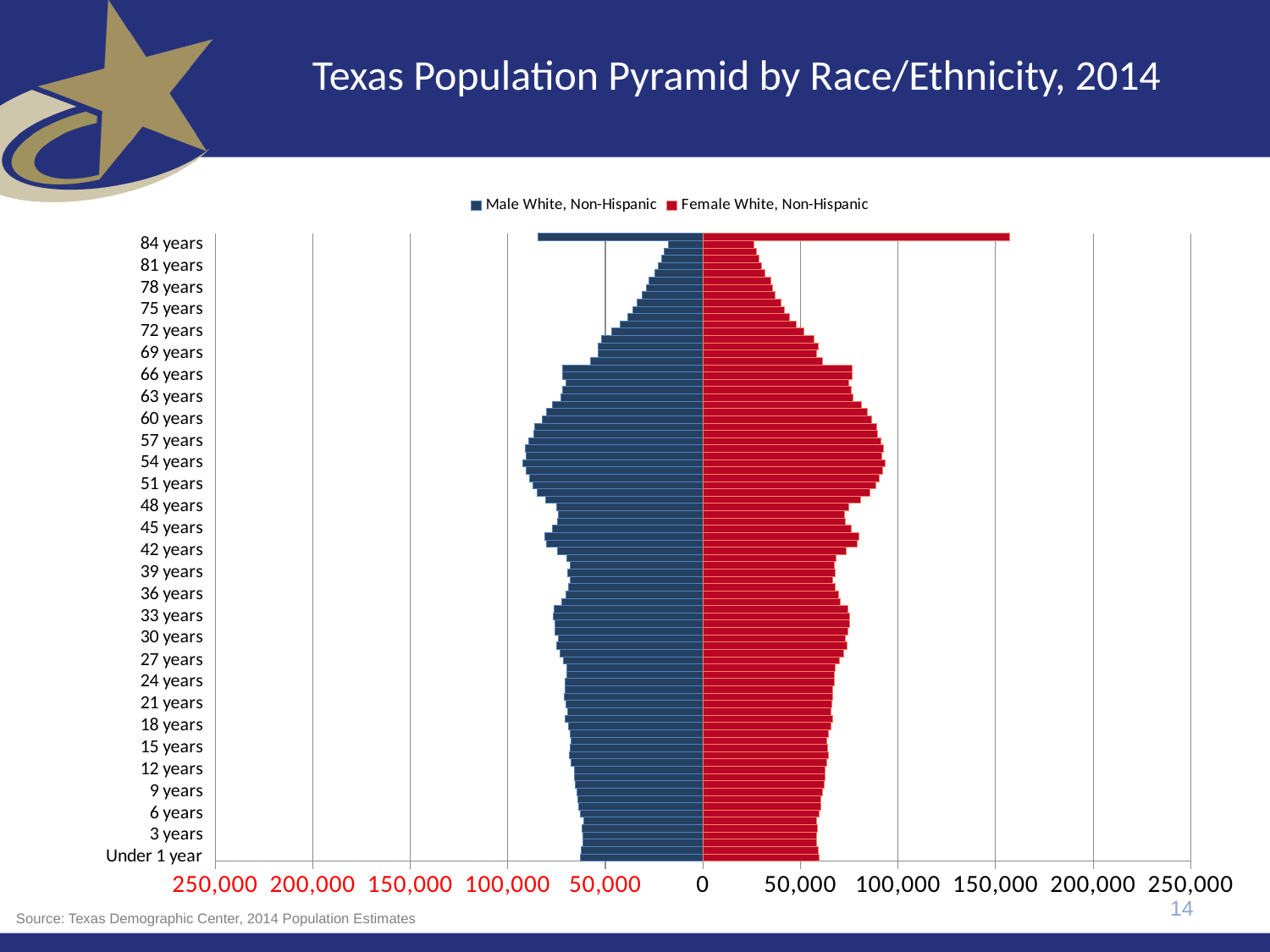
Is the Female White, Non-Hispanic value for 54 years greater or less than 50,000? greater Is the Male White, Non-Hispanic value for 84 years greater or less than 100,000? less How many series does the legend list? 2 Is the Female White, Non-Hispanic value for 84 years greater or less than 150,000? less Which series is shown in red in the chart? Female White, Non-Hispanic For the 84 years age group, which is larger: the Male White, Non-Hispanic bar or the Female White, Non-Hispanic bar? Female White, Non-Hispanic For Female White, Non-Hispanic, which is larger: the bar for 84 years or the bar for 54 years? 54 years What kind of chart is shown on the slide? Bar chart What is the title of the chart on the slide? Texas Population Pyramid by Race/Ethnicity, 2014